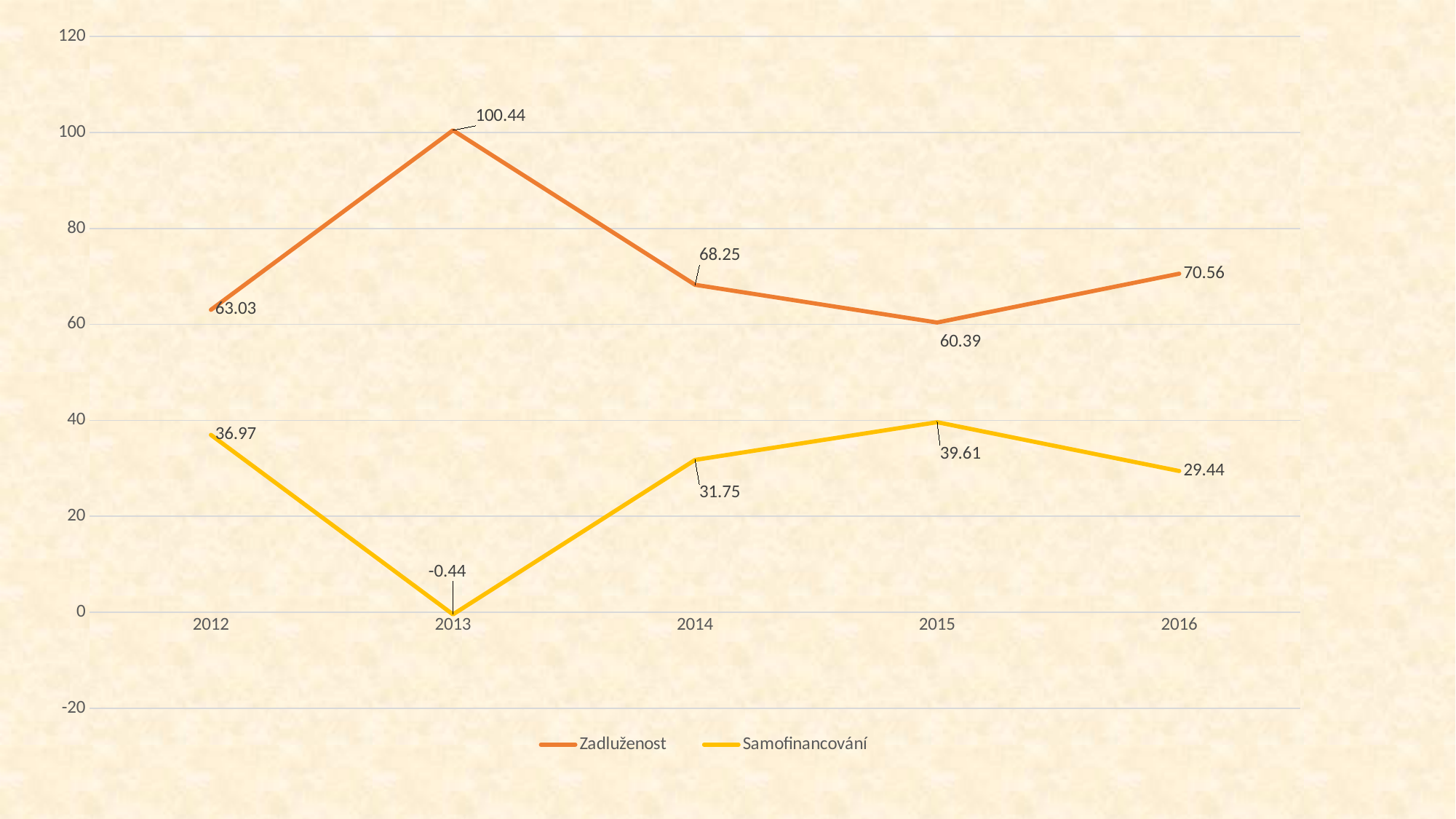
What is the value of Samofinancování in 2013? -0.44 What is the value of Samofinancování in 2015? 39.61 What is the value of Zadluženost in 2016? 70.56 What is the difference between Zadluženost and Samofinancování in 2012? 26.06 In which year is Samofinancování lowest? 2013 How many series does the legend list? 2 Does Samofinancování rise or fall from 2015 to 2016? Fall How many years are shown on the x axis? 5 What is the value of Zadluženost in 2013? 100.44 What kind of chart is shown on the slide? Line chart Which is larger in 2014: Zadluženost or Samofinancování? Zadluženost In which year is Zadluženost highest? 2013